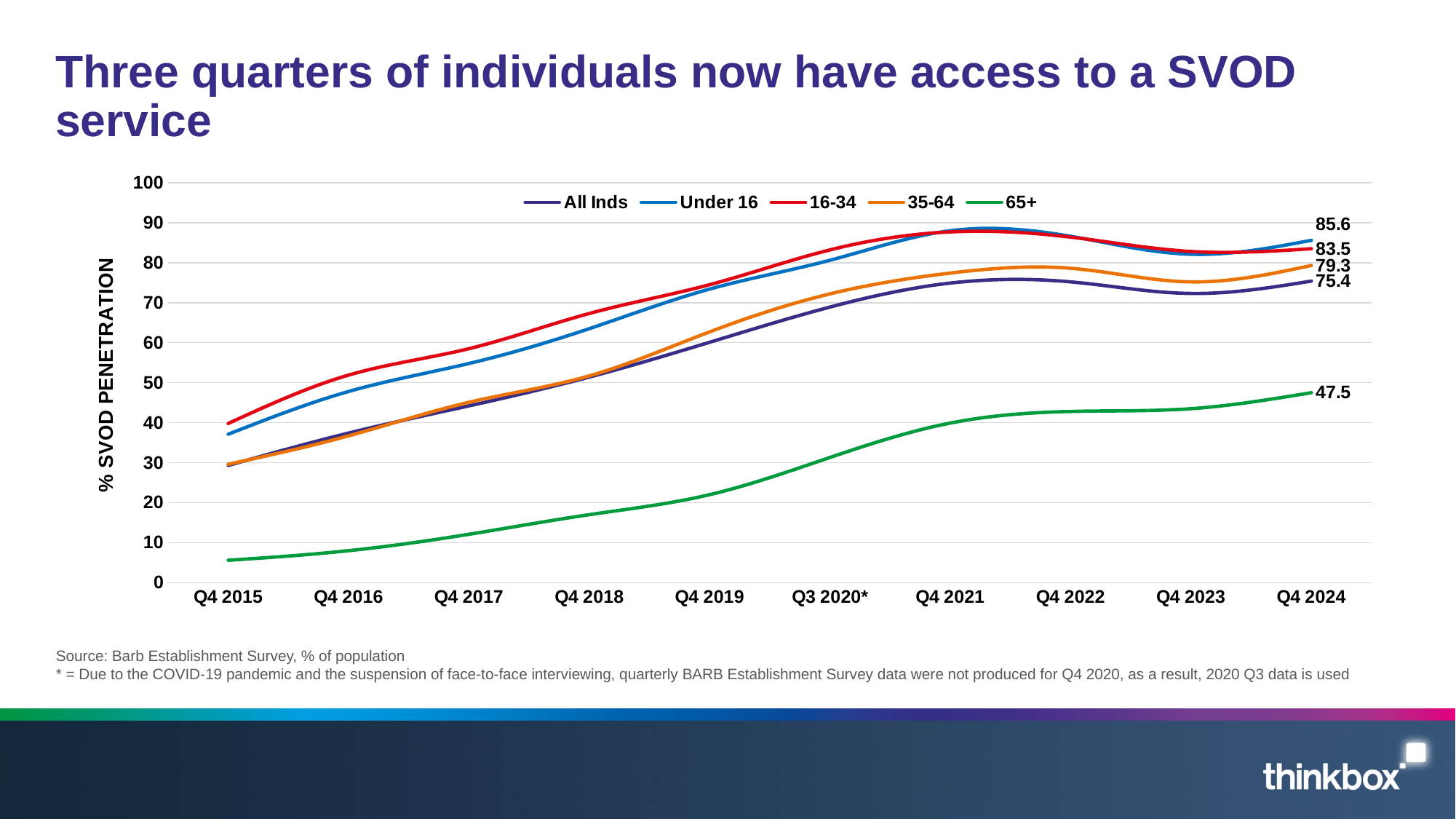
Does the 65+ series rise or fall from Q4 2015 to Q4 2024? rise Which series has the lowest value in Q4 2024? 65+ What is the SVOD penetration for Under 16 in Q4 2024? 85.6 What type of chart is shown on the slide? line chart Which series has the highest value in Q4 2024? Under 16 How many time points are shown on the x axis? 10 What is the difference between the 35-64 and 65+ values in Q4 2024? 31.8 What is the label on the y axis? % SVOD PENETRATION How many series does the legend list? 5 Is the value for 65+ in Q4 2015 greater or less than 10? less What is the SVOD penetration for All Inds in Q4 2024? 75.4 What is the SVOD penetration for 65+ in Q4 2024? 47.5